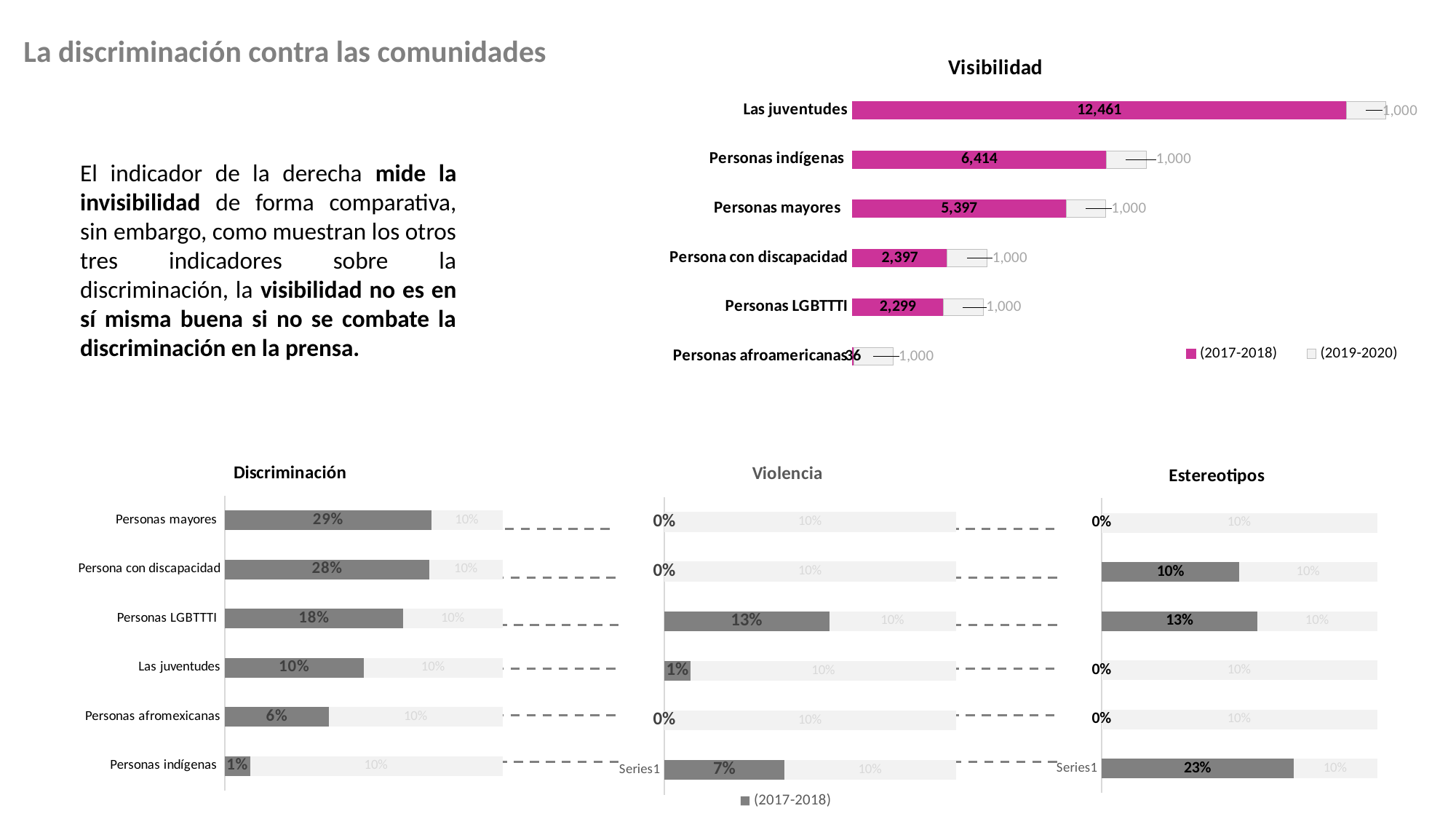
In the Visibilidad chart, what is the (2017-2018) value for Personas mayores? 5,397 In the Discriminación chart, how many categories are shown? 6 In the Visibilidad chart, what is the (2019-2020) value shown for Personas LGBTTTI? 1,000 In the Visibilidad chart, what is the (2017-2018) value for Las juventudes? 12,461 In the Discriminación chart, which is larger, the value for Las juventudes or the value for Personas afromexicanas? Las juventudes What is the highest value shown in the Violencia chart? 13% In the Discriminación chart, what is the (2017-2018) value for Personas LGBTTTI? 18% In the Discriminación chart, which category has the highest (2017-2018) value? Personas mayores In the Visibilidad chart, which category has the lowest (2017-2018) value? Personas afroamericanas In the Visibilidad chart, what is the difference between the (2017-2018) values for Personas indígenas and Persona con discapacidad? 4,017 In the Visibilidad chart, how many series does the legend list? 2 What is the highest value shown in the Estereotipos chart? 23%